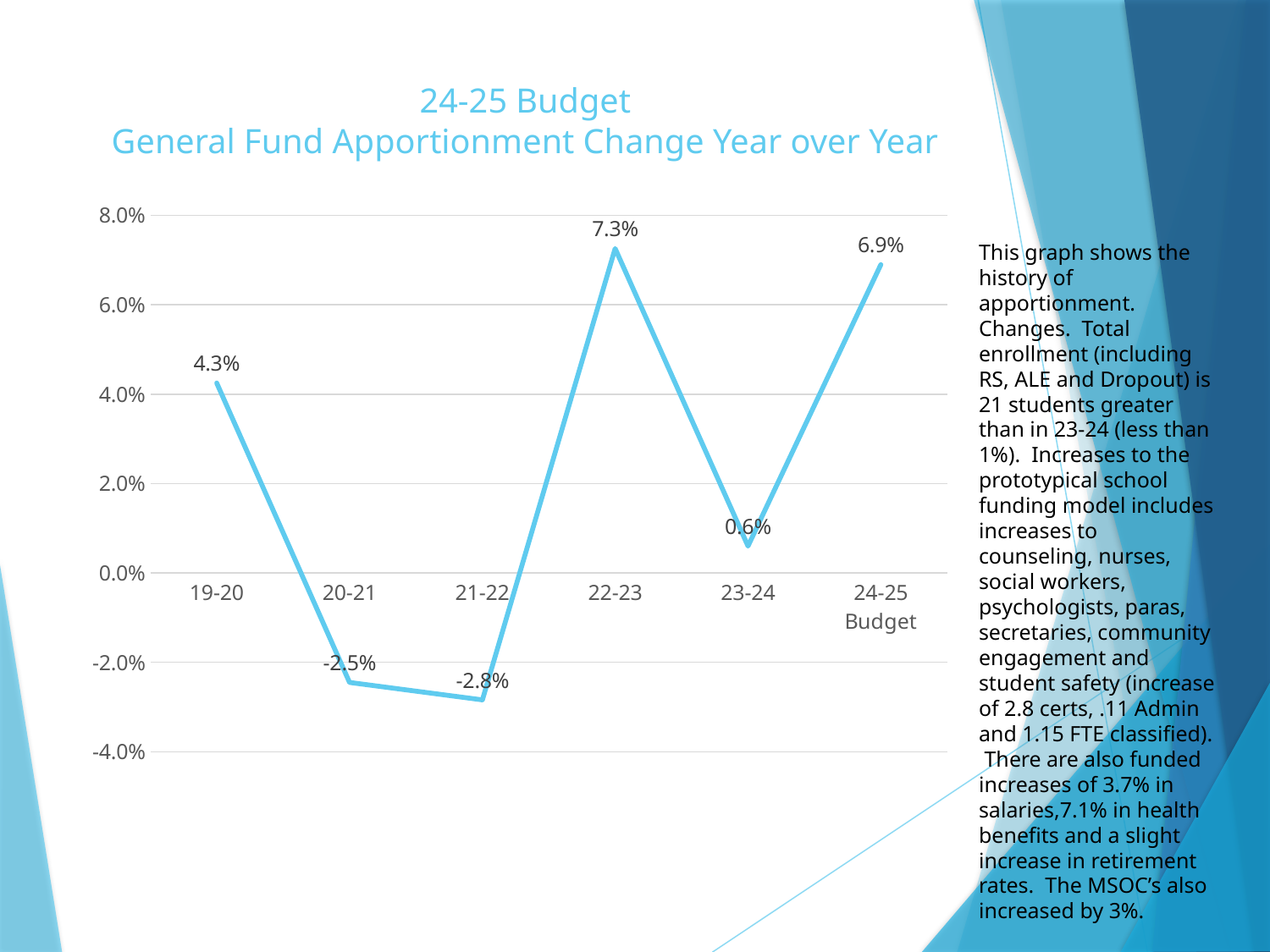
Does the value rise or fall from 23-24 to 24-25 Budget? rise What kind of chart is shown on the slide? line chart What is the difference between the values for 22-23 and 23-24? 6.7% Which is larger, the value for 19-20 or the value for 24-25 Budget? 24-25 Budget What is the value shown for 22-23? 7.3% Is the value for 20-21 greater or less than 0.0%? less Which year has the highest apportionment change? 22-23 What is the value shown for the 24-25 Budget? 6.9% How many years are plotted on the chart? 6 Which year has the lowest apportionment change? 21-22 What is the general fund apportionment change for 19-20? 4.3% What is the value shown for 21-22? -2.8%